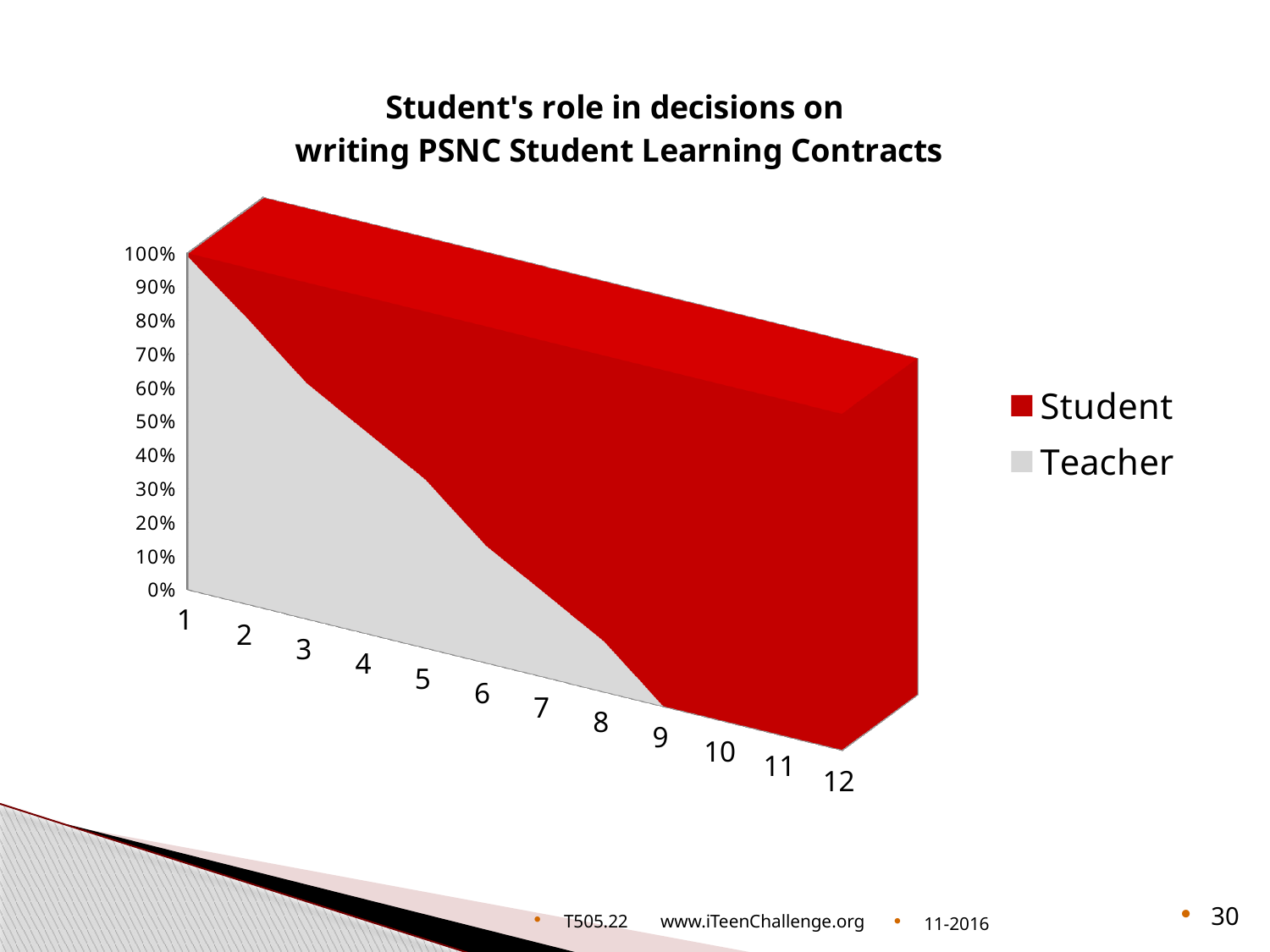
How many categories are shown along the x axis? 12 Does the Student share rise or fall as the categories go from 1 to 12? Rise Does the Teacher share rise or fall as the categories go from 1 to 12? Fall How many series does the legend list? 2 At category 8, which is larger, the Student share or the Teacher share? Student Is the Teacher value at category 2 greater or less than 50%? greater What is the title of the chart? Student's role in decisions on writing PSNC Student Learning Contracts Which colour represents the Student series in the legend? Red Is the Student value at category 8 greater or less than 50%? greater At category 3, which is larger, the Student share or the Teacher share? Teacher What kind of chart is shown on the slide? Area chart Is the Teacher value at category 7 greater or less than 50%? less